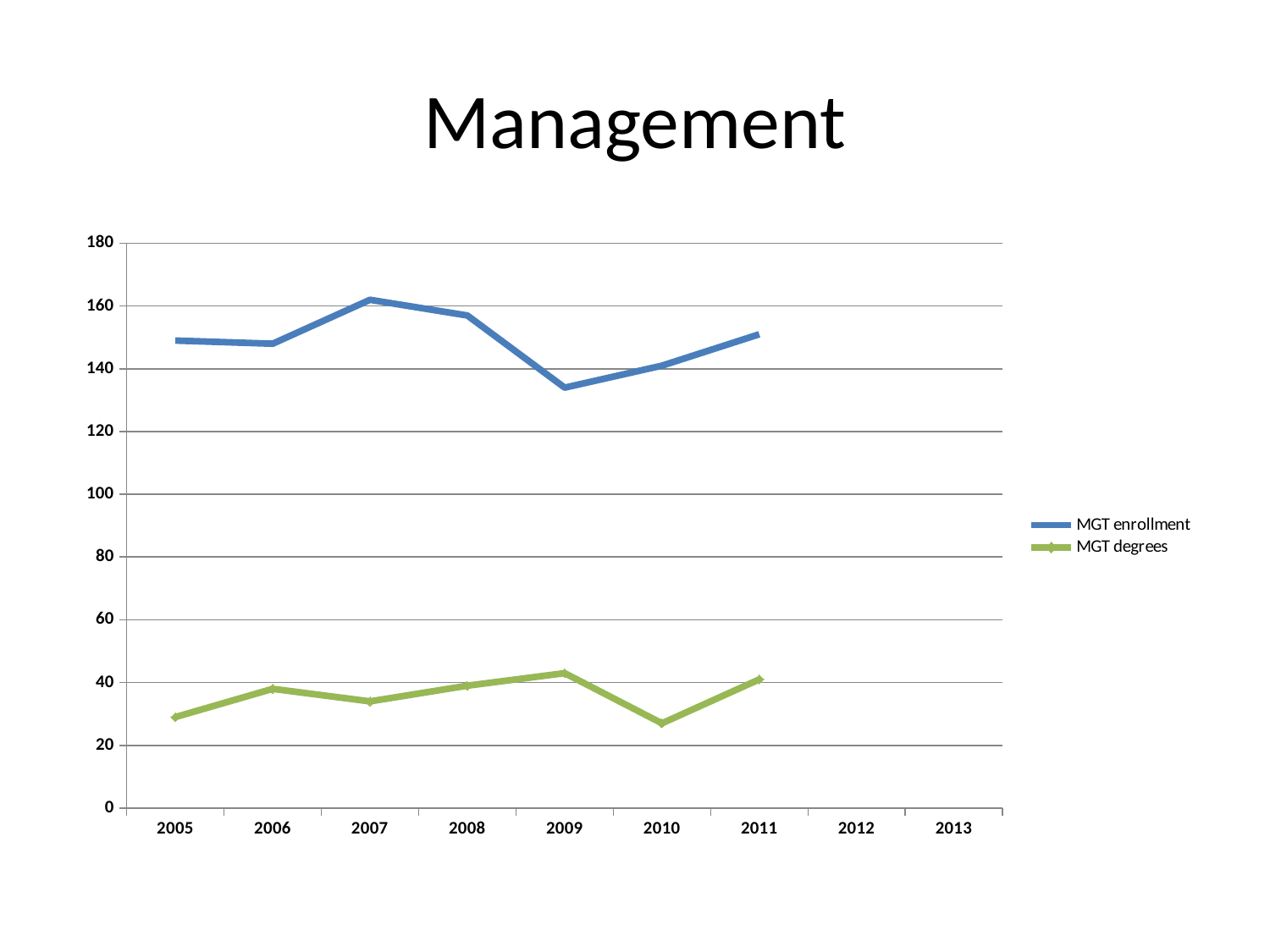
Which is larger, MGT enrollment in 2007 or MGT enrollment in 2009? MGT enrollment in 2007 Is the value for MGT enrollment in 2009 greater or less than 140? less Does MGT enrollment rise or fall from 2009 to 2011? rise What colour is the MGT degrees line? green In which year is MGT degrees highest? 2009 Is the value for MGT degrees in 2010 greater or less than 40? less Is the value for MGT enrollment in 2007 greater or less than 160? greater In which year is MGT enrollment lowest? 2009 How many series does the legend list? 2 What kind of chart is shown on the slide? line chart In which year is MGT degrees lowest? 2010 In which year is MGT enrollment highest? 2007